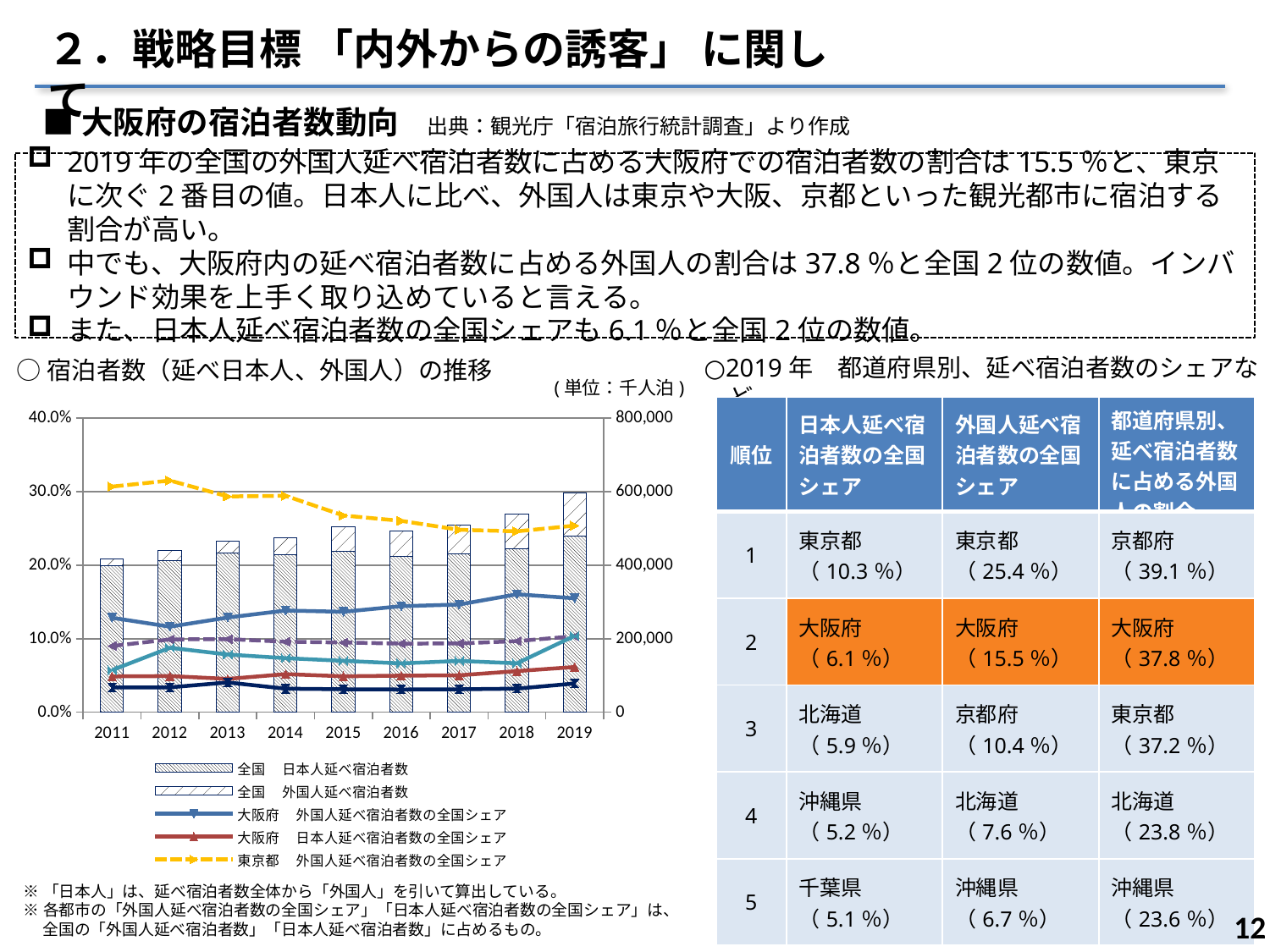
In 2019, which is larger: the 東京都 外国人延べ宿泊者数の全国シェア or the 大阪府 外国人延べ宿泊者数の全国シェア? 東京都 外国人延べ宿泊者数の全国シェア Is the 大阪府 日本人延べ宿泊者数の全国シェア value for 2015 greater or less than 10.0%? less How many years are shown on the x axis of the chart? 9 How many entries does the chart's legend list? 5 What unit is given for the bar values in the chart? 千人泊 What is the title of the chart? 宿泊者数（延べ日本人、外国人）の推移 Does the 東京都 外国人延べ宿泊者数の全国シェア line rise or fall from 2011 to 2019? Fall Does the total height of the stacked bars rise or fall from 2011 to 2019? Rise What kind of chart is shown on the slide? A combined bar and line chart Is the 東京都 外国人延べ宿泊者数の全国シェア value for 2019 greater or less than 30.0%? less Is the total stacked bar for 2019 greater or less than 400,000? greater Which year has the tallest total stacked bar? 2019